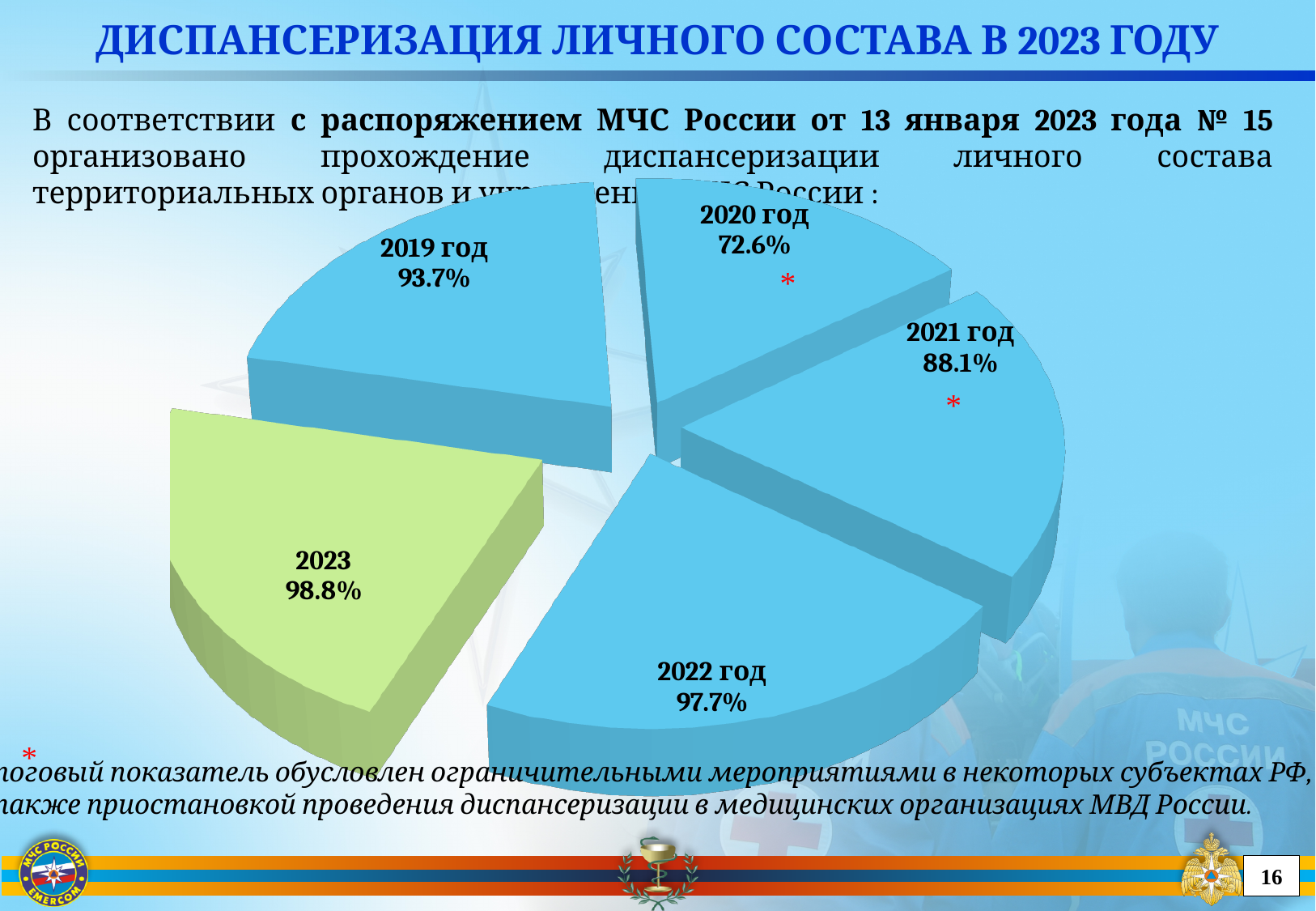
What value is shown for 2020 год? 72.6% Which is larger, the value for 2019 год or the value for 2021 год? 2019 год Which year has the highest value on the chart? 2023 What value is shown for 2021 год? 88.1% What is the difference between the values for 2023 and 2022 год? 1.1% What kind of chart is shown on the slide? pie chart What value is shown for 2022 год? 97.7% Which year has the lowest value on the chart? 2020 год What value is shown for 2019 год? 93.7% What value is shown for 2023? 98.8% How many slices does the pie chart have? 5 Which slice of the pie chart is coloured green rather than blue? 2023